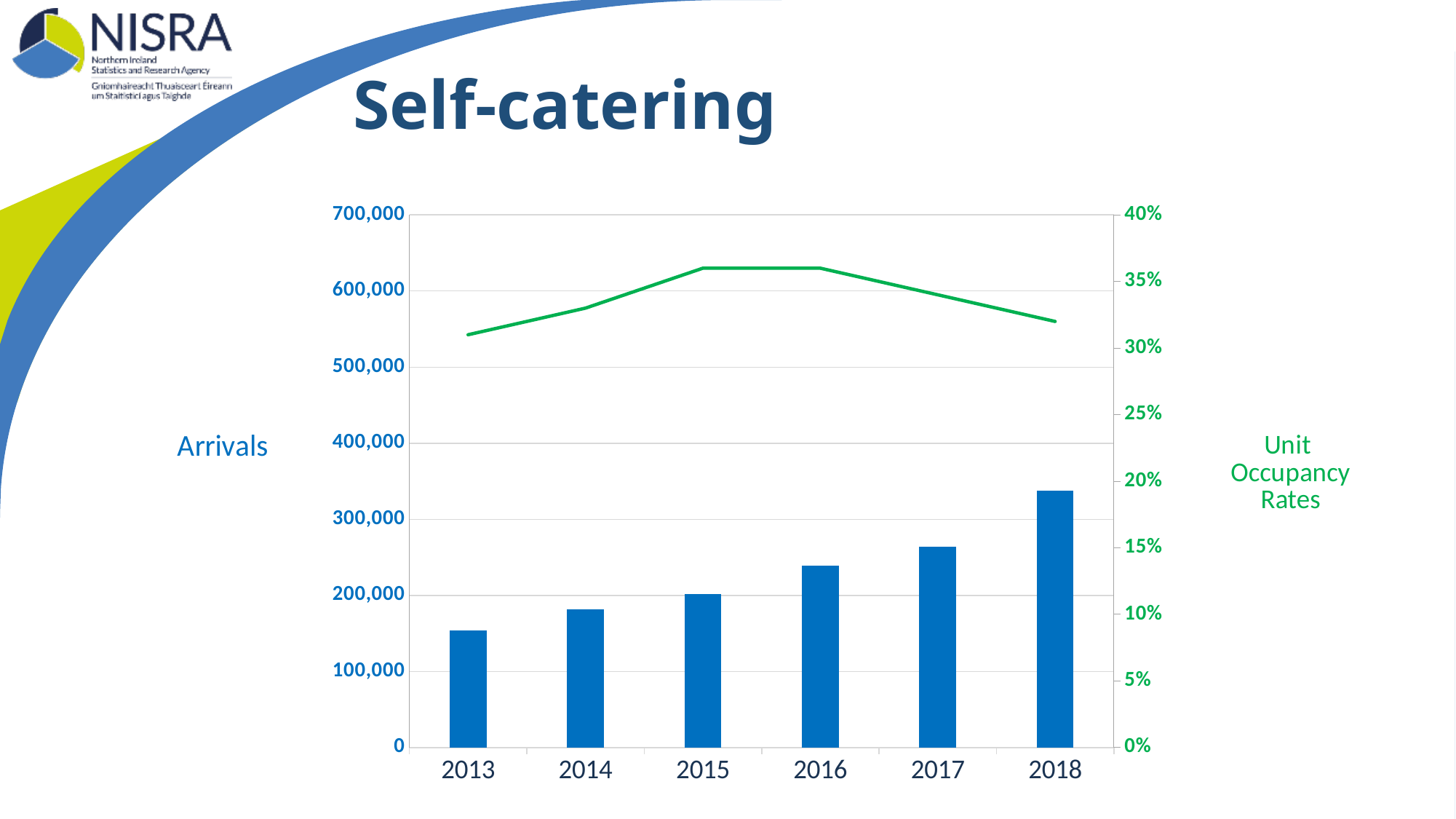
Is the arrivals value for 2013 greater or less than 200,000? less Is the unit occupancy rate for 2018 greater or less than 35%? less Is the arrivals value for 2018 greater or less than 300,000? greater What kind of chart is used to show arrivals? bar chart Do arrivals rise or fall from 2013 to 2018? rise What is the label of the right-hand axis? Unit Occupancy Rates Which year has the highest number of arrivals? 2018 How many years are shown on the x axis? 6 Which year has the lowest number of arrivals? 2013 Which year has more arrivals, 2014 or 2017? 2017